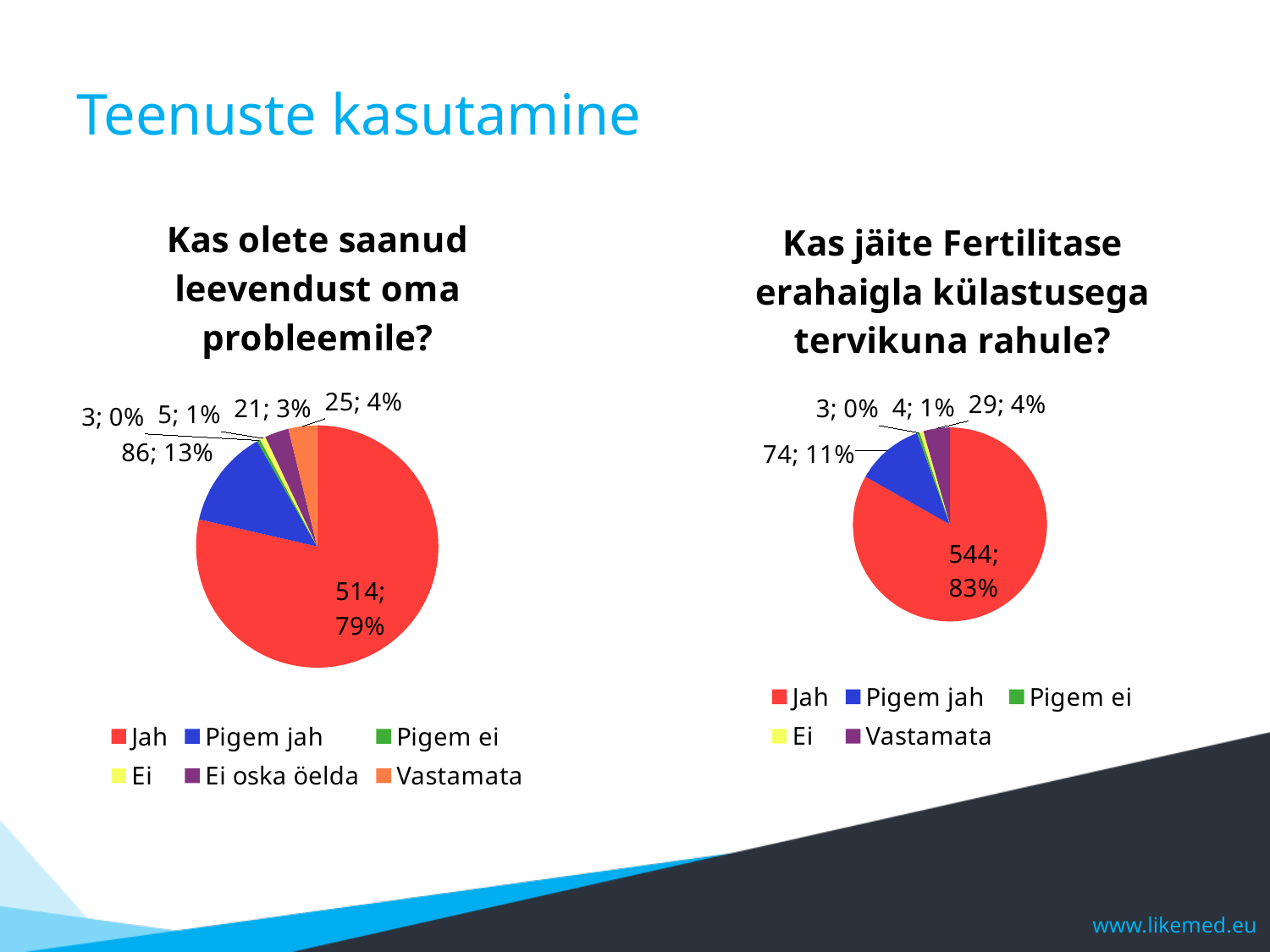
In the right chart 'Kas jäite Fertilitase erahaigla külastusega tervikuna rahule?', which category has the largest slice? Jah In the left chart 'Kas olete saanud leevendust oma probleemile?', what percentage is shown for Pigem jah? 13% In the right chart 'Kas jäite Fertilitase erahaigla külastusega tervikuna rahule?', what is the count shown for Pigem jah? 74 In the left chart 'Kas olete saanud leevendust oma probleemile?', what is the value shown for Jah? 514; 79% In the left chart 'Kas olete saanud leevendust oma probleemile?', what is the count shown for Vastamata? 25 What type of chart is used for 'Kas olete saanud leevendust oma probleemile?'? Pie chart In the left chart 'Kas olete saanud leevendust oma probleemile?', what is the difference in count between Jah and Pigem jah? 428 How many categories does the legend of the left chart 'Kas olete saanud leevendust oma probleemile?' list? 6 In the right chart 'Kas jäite Fertilitase erahaigla külastusega tervikuna rahule?', what is the value shown for Jah? 544; 83% In the left chart 'Kas olete saanud leevendust oma probleemile?', which category has the smallest slice? Pigem ei How many categories does the legend of the right chart 'Kas jäite Fertilitase erahaigla külastusega tervikuna rahule?' list? 5 In the right chart 'Kas jäite Fertilitase erahaigla külastusega tervikuna rahule?', which is larger: Pigem jah or Vastamata? Pigem jah